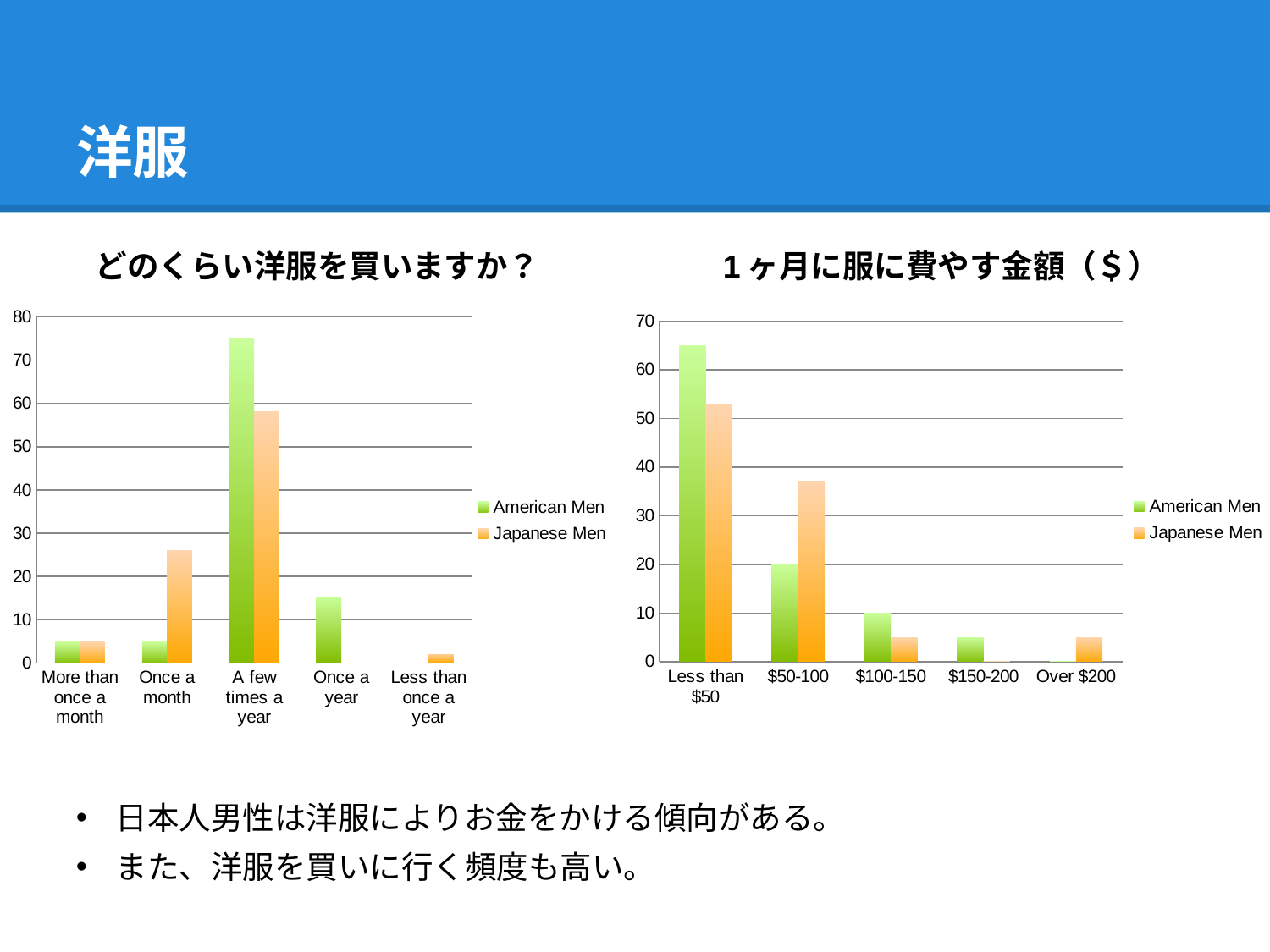
On the chart titled 'どのくらい洋服を買いますか？', how many categories are shown on the x axis? 5 On the chart titled '1ヶ月に服に費やす金額（$）', what is the value for American Men at '$50-100'? 20 On the chart titled 'どのくらい洋服を買いますか？', is the value for American Men at 'A few times a year' greater or less than 70? greater What kind of chart is the chart titled '1ヶ月に服に費やす金額（$）'? bar chart On the chart titled 'どのくらい洋服を買いますか？', which category has the highest value for American Men? A few times a year On the chart titled '1ヶ月に服に費やす金額（$）', how many series does the legend list? 2 On the chart titled 'どのくらい洋服を買いますか？', which is larger at 'Once a month': American Men or Japanese Men? Japanese Men On the chart titled '1ヶ月に服に費やす金額（$）', which is larger at '$50-100': American Men or Japanese Men? Japanese Men On the chart titled 'どのくらい洋服を買いますか？', is the value for Japanese Men at 'Once a month' greater or less than 20? greater On the chart titled '1ヶ月に服に費やす金額（$）', is the value for American Men at 'Less than $50' greater or less than 60? greater On the chart titled '1ヶ月に服に費やす金額（$）', which category has the highest value for Japanese Men? Less than $50 On the chart titled '1ヶ月に服に費やす金額（$）', what is the value for American Men at '$100-150'? 10